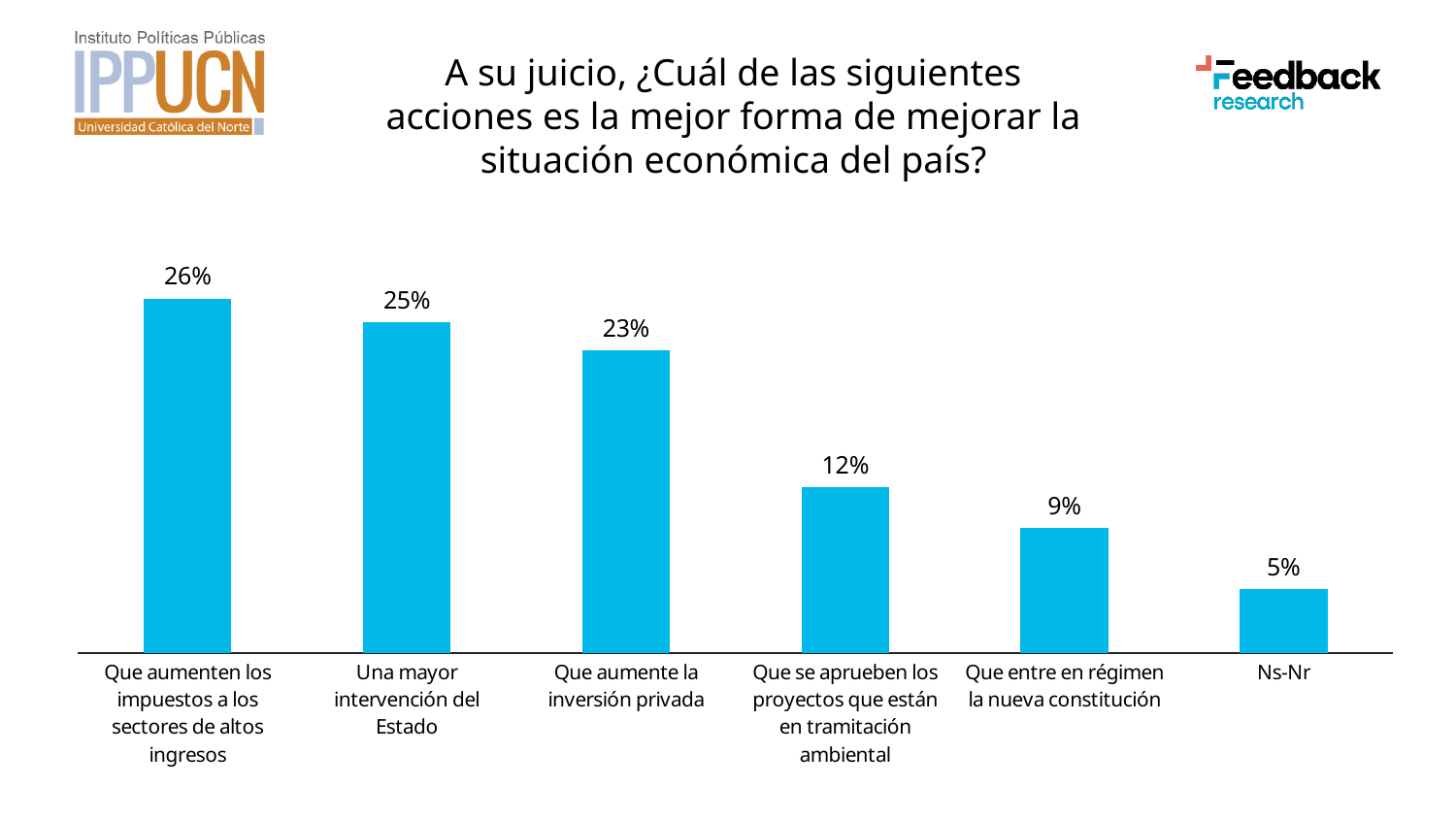
What percentage is shown for "Que entre en régimen la nueva constitución"? 9% Which category has the lowest value? Ns-Nr What is the value for "Que aumente la inversión privada"? 23% What kind of chart is shown on the slide? Bar chart How many categories are shown in the chart? 6 What percentage chose "Que aumenten los impuestos a los sectores de altos ingresos"? 26% What is the value for "Ns-Nr"? 5% Which category has the highest value? Que aumenten los impuestos a los sectores de altos ingresos What is the value for "Una mayor intervención del Estado"? 25% Which is larger: "Que se aprueben los proyectos que están en tramitación ambiental" or "Que entre en régimen la nueva constitución"? Que se aprueben los proyectos que están en tramitación ambiental Do the values rise or fall from left to right along the x axis? Fall What is the difference between "Que aumente la inversión privada" and "Que se aprueben los proyectos que están en tramitación ambiental"? 11%